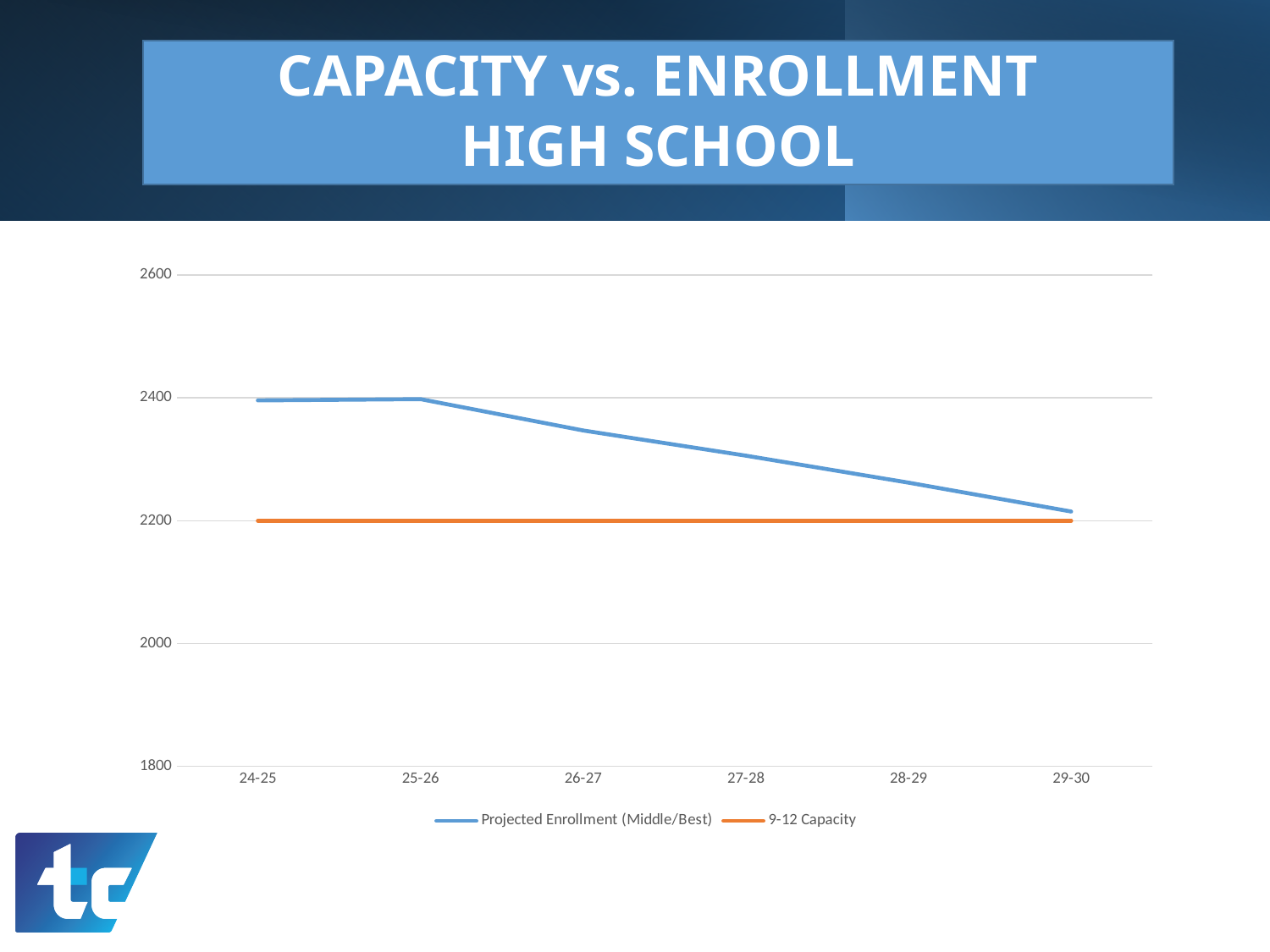
What is the title of the slide containing the chart? CAPACITY vs. ENROLLMENT HIGH SCHOOL What is the value of the 9-12 Capacity line? 2200 At 27-28, which is larger: Projected Enrollment (Middle/Best) or 9-12 Capacity? Projected Enrollment (Middle/Best) Is the Projected Enrollment (Middle/Best) value for 24-25 greater or less than 2200? greater Which colour is used for the 9-12 Capacity line? Orange In which school year is Projected Enrollment (Middle/Best) lowest? 29-30 How many school years are shown on the x axis? 6 What kind of chart is shown on the slide? Line chart Is the Projected Enrollment (Middle/Best) value for 26-27 greater or less than 2400? less How many series does the legend list? 2 Does the Projected Enrollment (Middle/Best) line rise or fall from 25-26 to 29-30? Fall Is the Projected Enrollment (Middle/Best) value for 28-29 greater or less than 2400? less